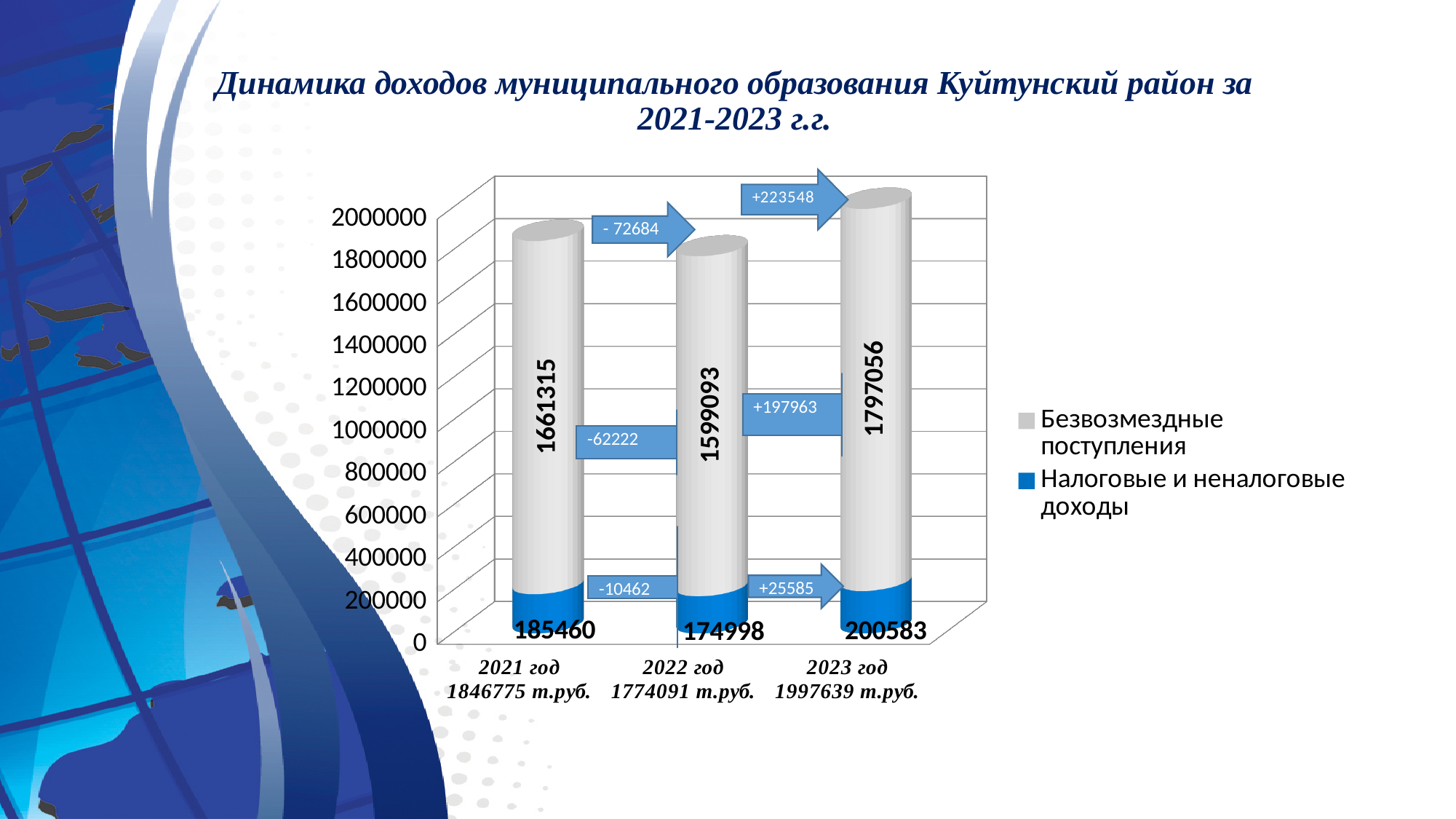
Which colour represents Налоговые и неналоговые доходы in the chart? Blue How many years are shown on the x axis? 3 What is the difference between the Безвозмездные поступления values for 2023 год and 2022 год? 197963 How many series does the legend list? 2 Which year has the lowest value for Налоговые и неналоговые доходы? 2022 год Which is larger: Налоговые и неналоговые доходы in 2021 год or in 2022 год? 2021 год What is the value of Безвозмездные поступления for 2021 год? 1661315 What kind of chart is shown on the slide? Stacked bar chart Which year has the highest value for Безвозмездные поступления? 2023 год What is the total of the stacked bar for 2023 год? 1997639 What is the value of Налоговые и неналоговые доходы for 2023 год? 200583 What is the value of Безвозмездные поступления for 2022 год? 1599093